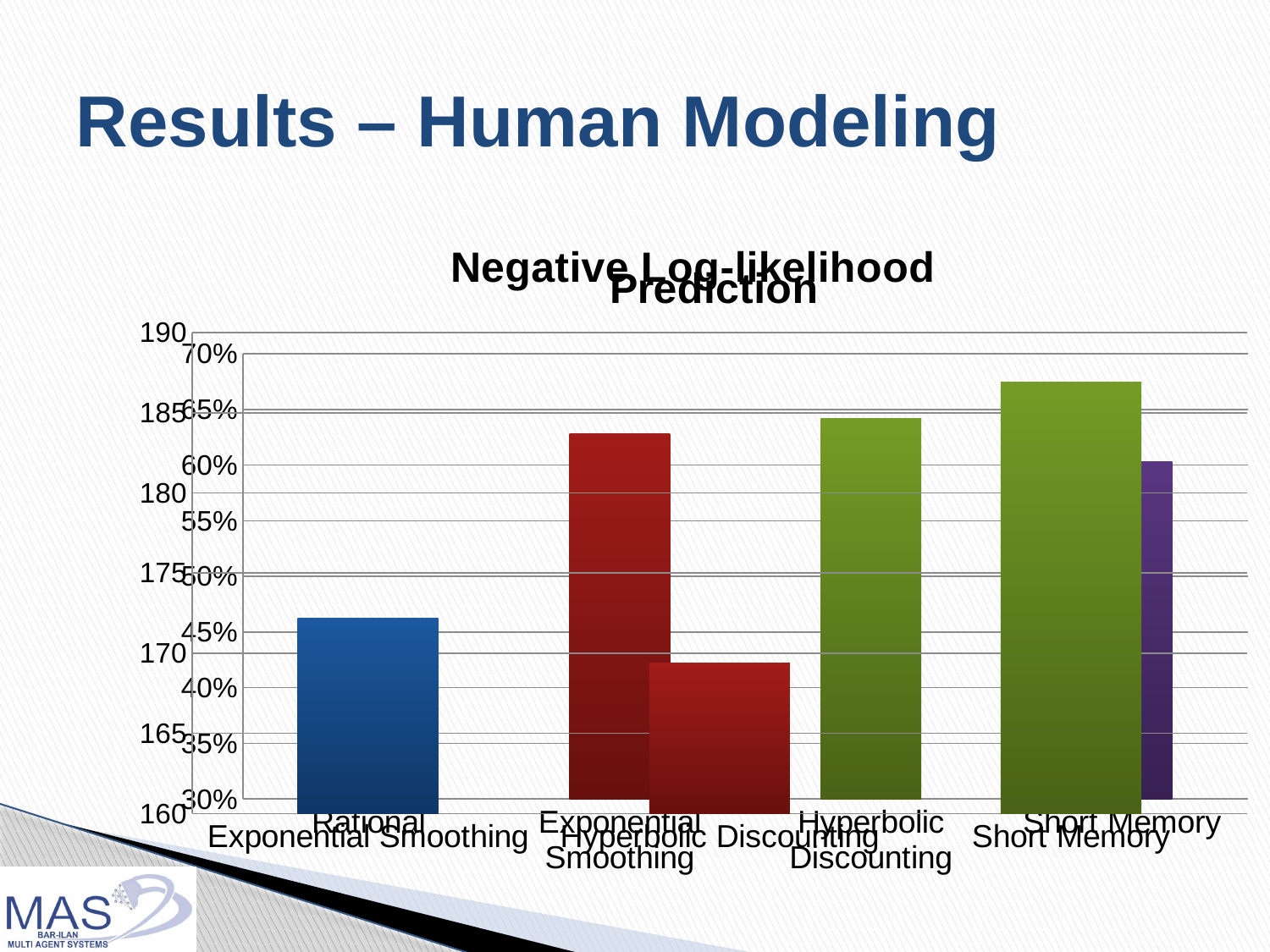
How many categories does the Prediction chart show on its x axis? 4 In the Negative Log-likelihood chart, is the value for Exponential Smoothing greater or less than 180? less In the Prediction chart, is the value for Hyperbolic Discounting greater or less than 40%? greater In the Negative Log-likelihood chart, which category has the lowest value? Hyperbolic Discounting In the Prediction chart, which category has the highest value? Hyperbolic Discounting What kind of chart is the Negative Log-likelihood chart? bar chart How many categories does the Negative Log-likelihood chart show on its x axis? 3 What is the lowest tick value shown on the y axis of the Negative Log-likelihood chart? 160 In the Prediction chart, is the value for Hyperbolic Discounting greater or less than 45%? greater